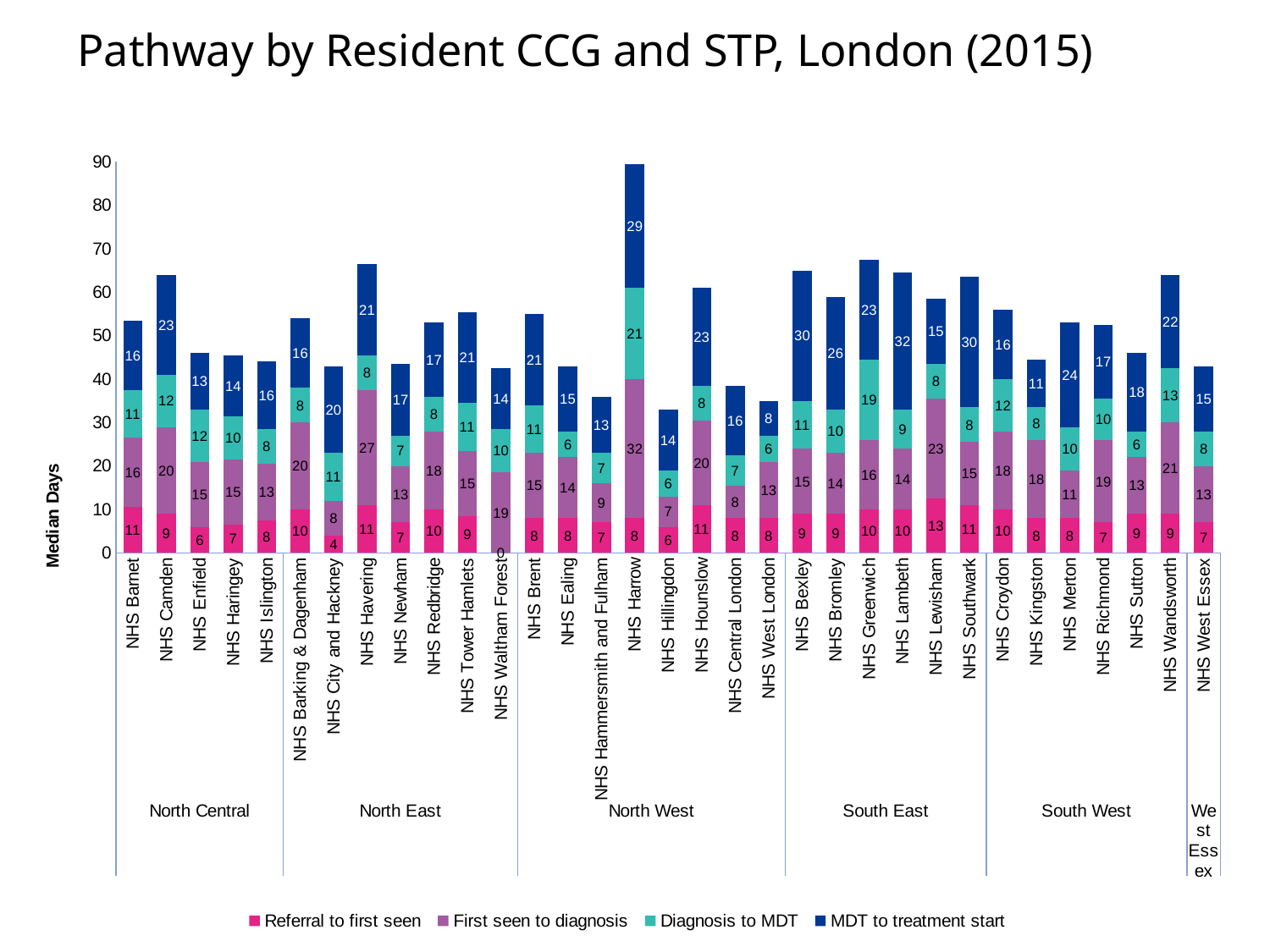
What is the total of the stacked bar for NHS Harrow? 90 What is the First seen to diagnosis value for NHS Havering? 27 What is the MDT to treatment start value for NHS Harrow? 29 Which has the larger MDT to treatment start value, NHS Lambeth or NHS Bexley? NHS Lambeth What is the total of the stacked bar for NHS Barnet? 54 How many series does the legend list? 4 What is the difference between the MDT to treatment start values for NHS Camden and NHS Barnet? 7 What is the Referral to first seen value for NHS City and Hackney? 4 What is the title of the vertical axis? Median Days What kind of chart is shown on the slide? Stacked bar chart Is the total bar for NHS Harrow greater or less than 80? greater Which CCG has the tallest stacked bar overall? NHS Harrow